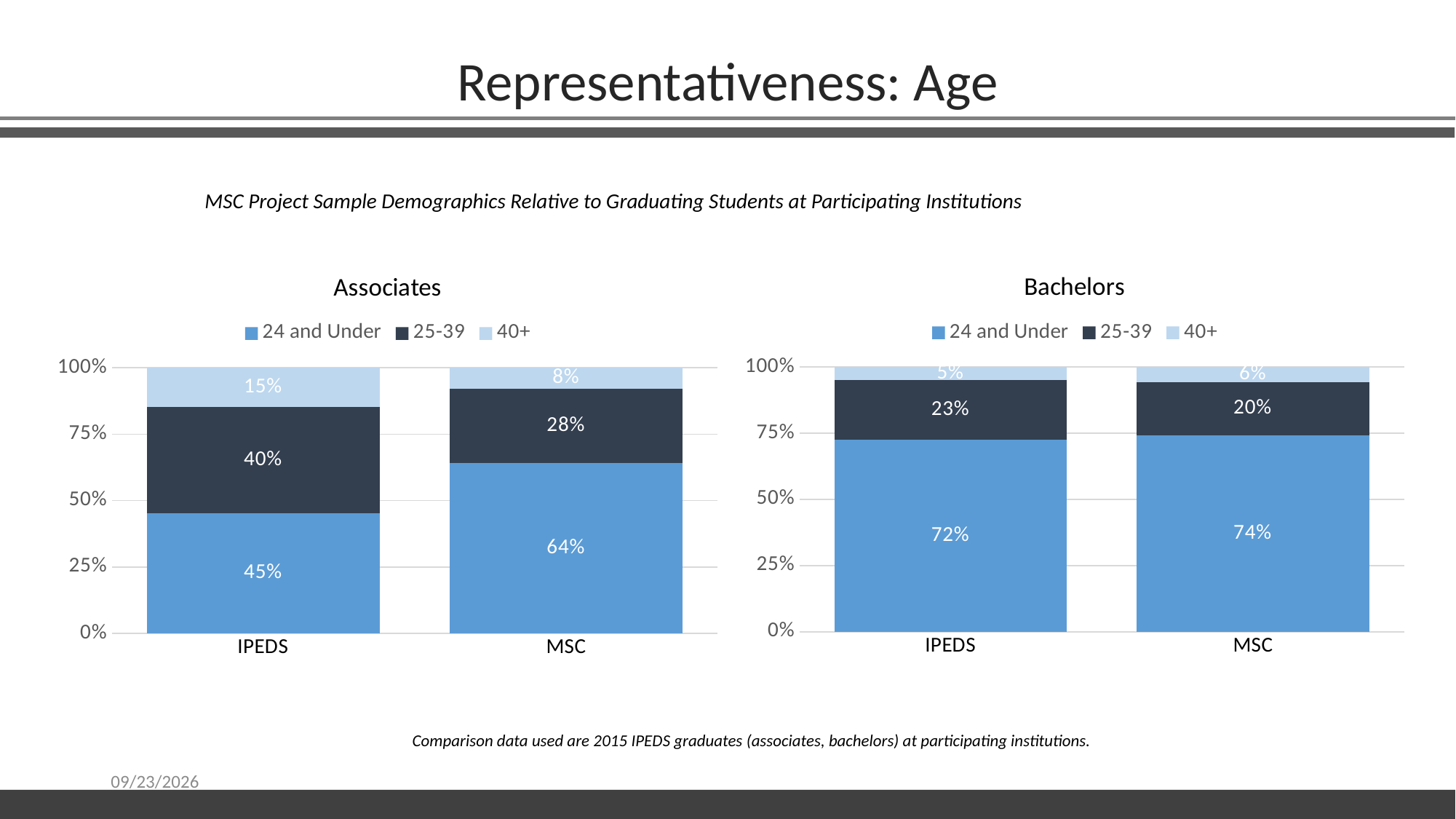
In the Bachelors chart, what is the value for 25-39 for IPEDS? 23% In the Bachelors chart, what is the value for 24 and Under for MSC? 74% In the Associates chart, what is the difference between the 24 and Under values for MSC and IPEDS? 19% In the Associates chart, what is the value for 40+ for IPEDS? 15% In the Associates chart, what is the value for 25-39 for MSC? 28% How many categories are shown on the x axis of the Associates chart? 2 In the Associates chart, what is the value for 24 and Under for IPEDS? 45% In the Associates chart, which category has the higher 40+ value, IPEDS or MSC? IPEDS What is the title of the chart on the left side of the slide? Associates In the Bachelors chart, which has the larger 25-39 value, IPEDS or MSC? IPEDS What kind of chart is the Bachelors chart? Stacked bar chart How many series does the legend of the Bachelors chart list? 3